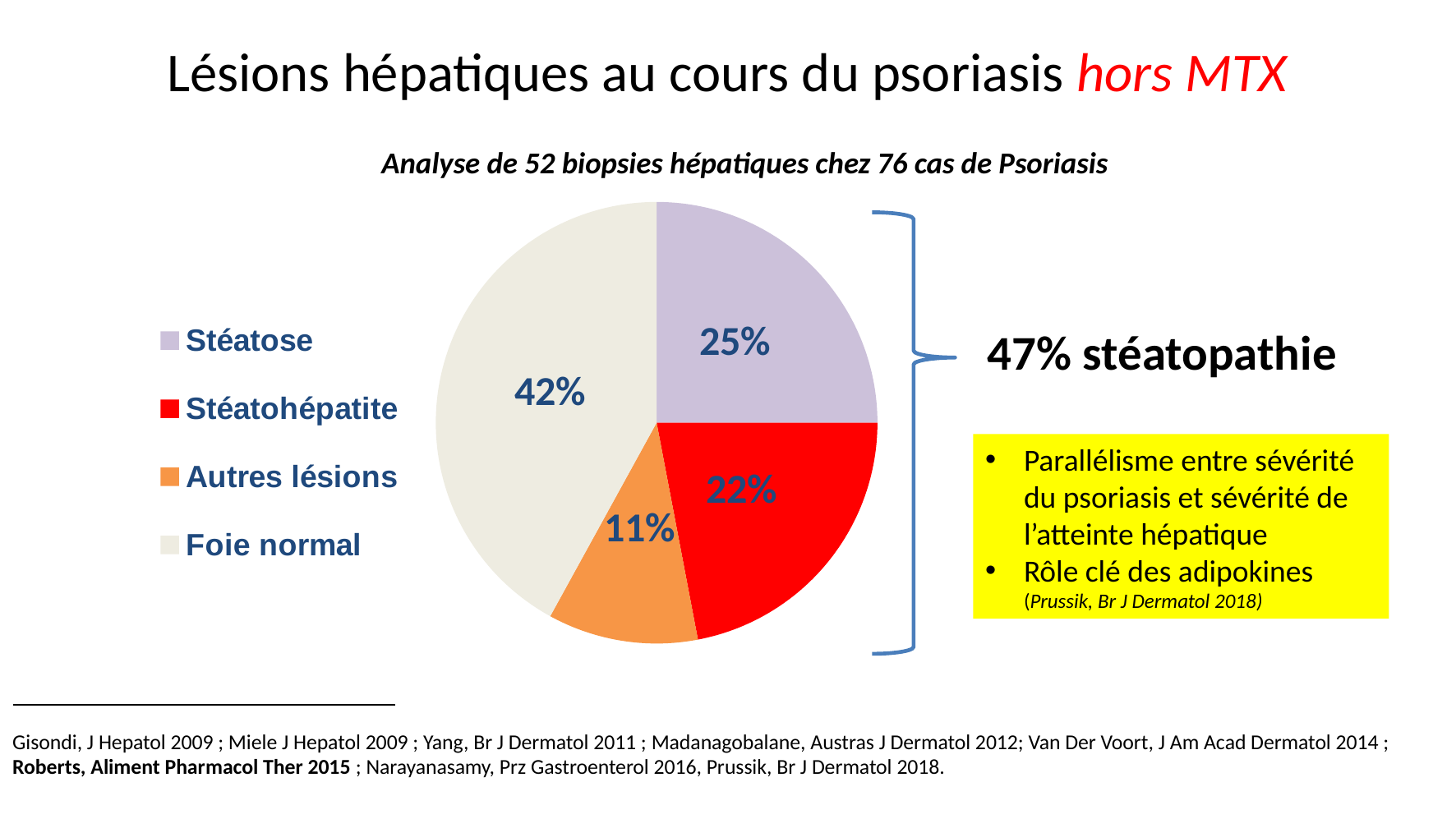
What share of the pie does Stéatohépatite represent? 22% What kind of chart is shown on the slide? pie chart What is the difference in percentage points between Foie normal and Stéatose? 17 Which is larger, the slice for Stéatose or the slice for Stéatohépatite? Stéatose What is the combined share of Stéatose and Stéatohépatite? 47% Which category has the largest slice of the pie? Foie normal How many categories does the pie chart show? 4 What share of the pie does Autres lésions represent? 11% What colour is the Stéatohépatite slice? red What share of the pie does Foie normal represent? 42% Which category has the smallest slice of the pie? Autres lésions